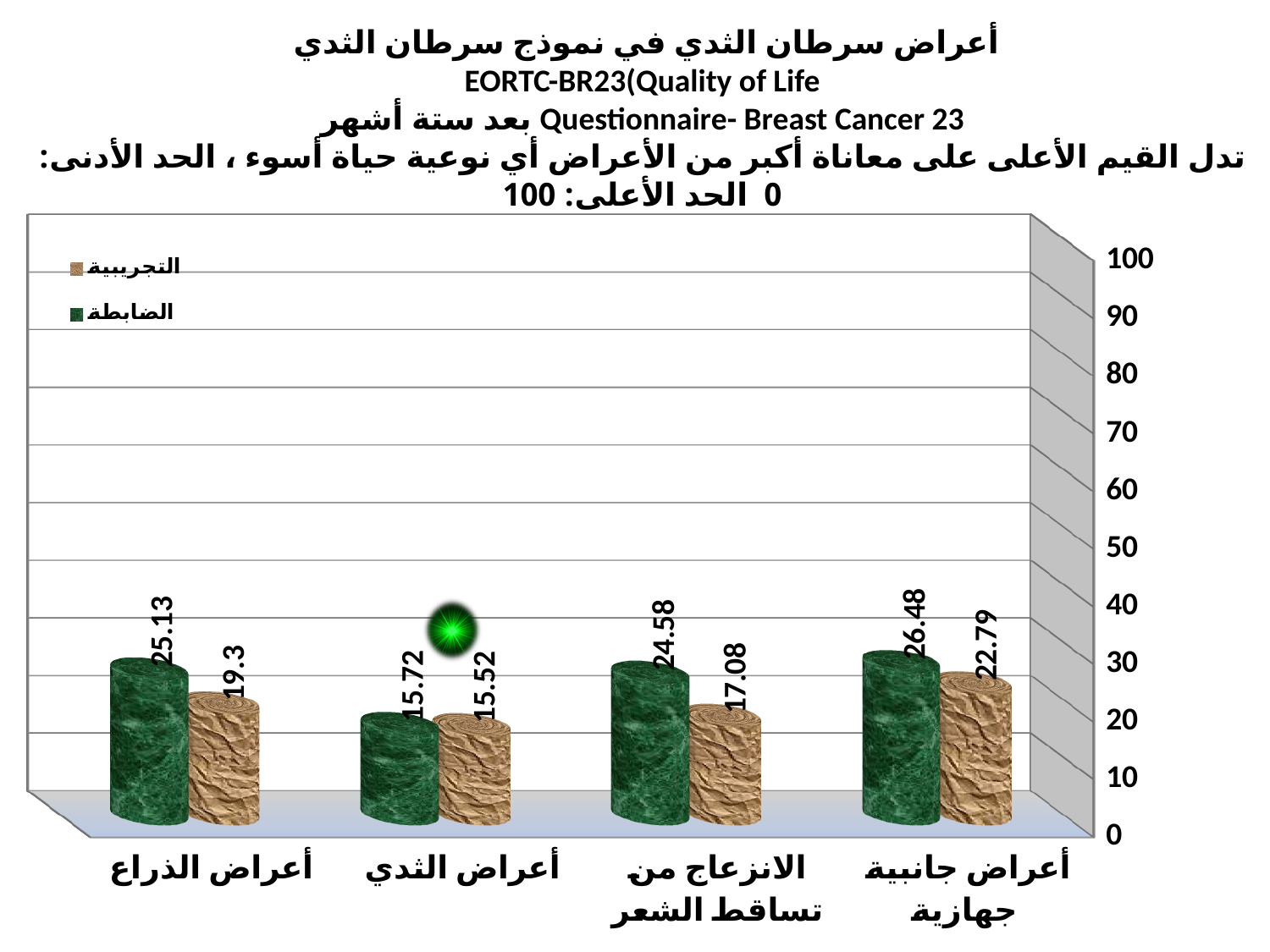
Which category has the highest value for الضابطة? أعراض جانبية جهازية For أعراض جانبية جهازية, which series has the larger value, الضابطة or التجريبية? الضابطة Which category has the lowest value for التجريبية? أعراض الثدي What is the value of الضابطة for أعراض الذراع? 25.13 What is the value of التجريبية for الانزعاج من تساقط الشعر? 17.08 How many series does the legend list? 2 What type of chart is shown on the slide? bar chart What is the value of التجريبية for أعراض الذراع? 19.3 Is the value of الضابطة for أعراض الثدي greater or less than 20? less What is the difference between الضابطة and التجريبية for الانزعاج من تساقط الشعر? 7.5 What is the value of الضابطة for أعراض جانبية جهازية? 26.48 How many categories are shown on the x axis? 4